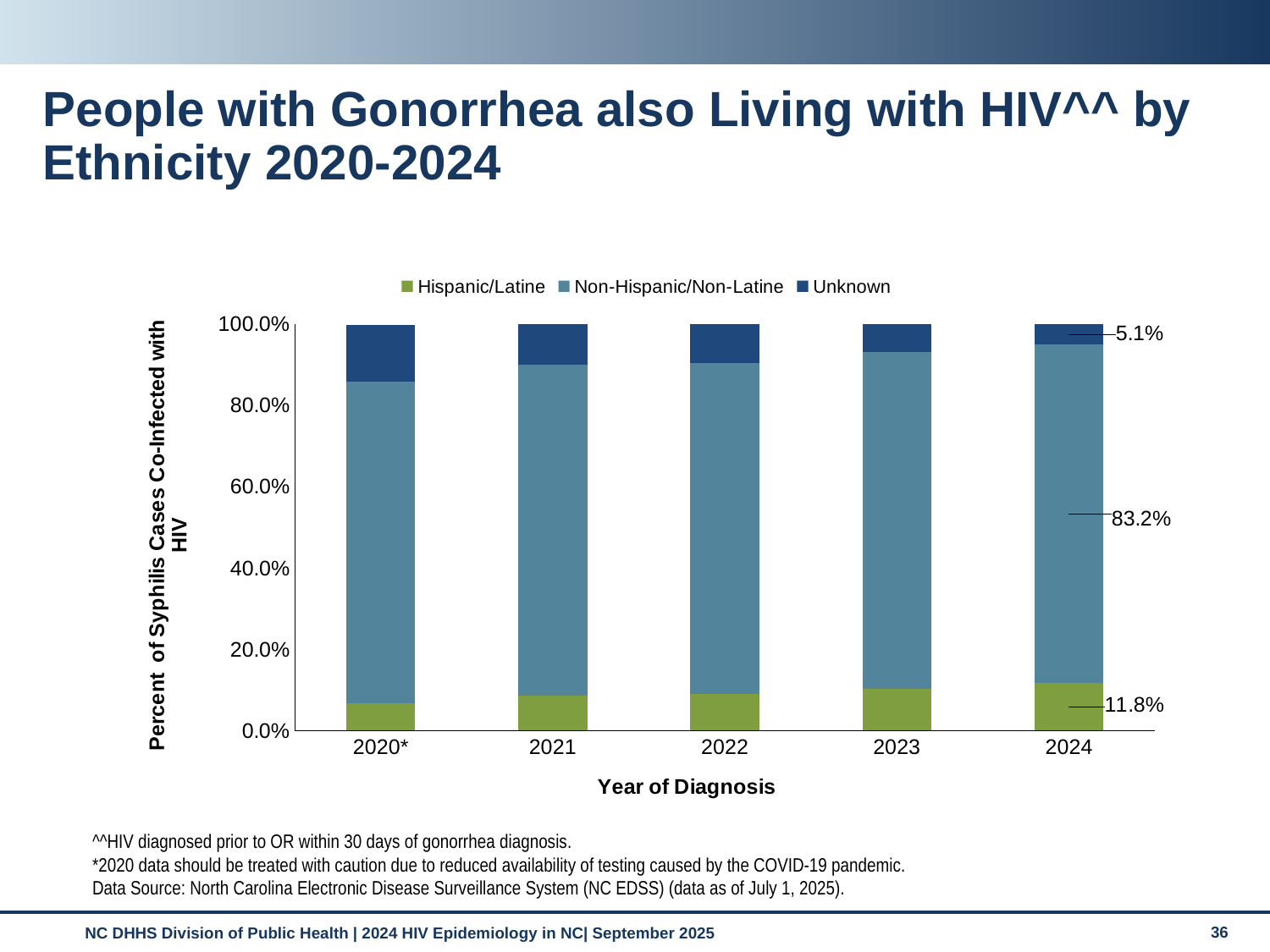
What is the difference between the Non-Hispanic/Non-Latine and Hispanic/Latine values in 2024? 71.4% What percentage of the 2024 bar is Non-Hispanic/Non-Latine? 83.2% What is the Unknown value for 2024? 5.1% Which ethnicity group has the largest share in 2024? Non-Hispanic/Non-Latine Is the Hispanic/Latine value for 2020* greater or less than 20%? less Which ethnicity group has the smallest share in 2024? Unknown Is the Hispanic/Latine share larger in 2020* or in 2024? 2024 How many years are shown on the x axis? 5 What kind of chart is shown on the slide? Stacked bar chart How many series does the legend list? 3 Is the Unknown share larger in 2020* or in 2024? 2020* What is the Hispanic/Latine value for 2024? 11.8%